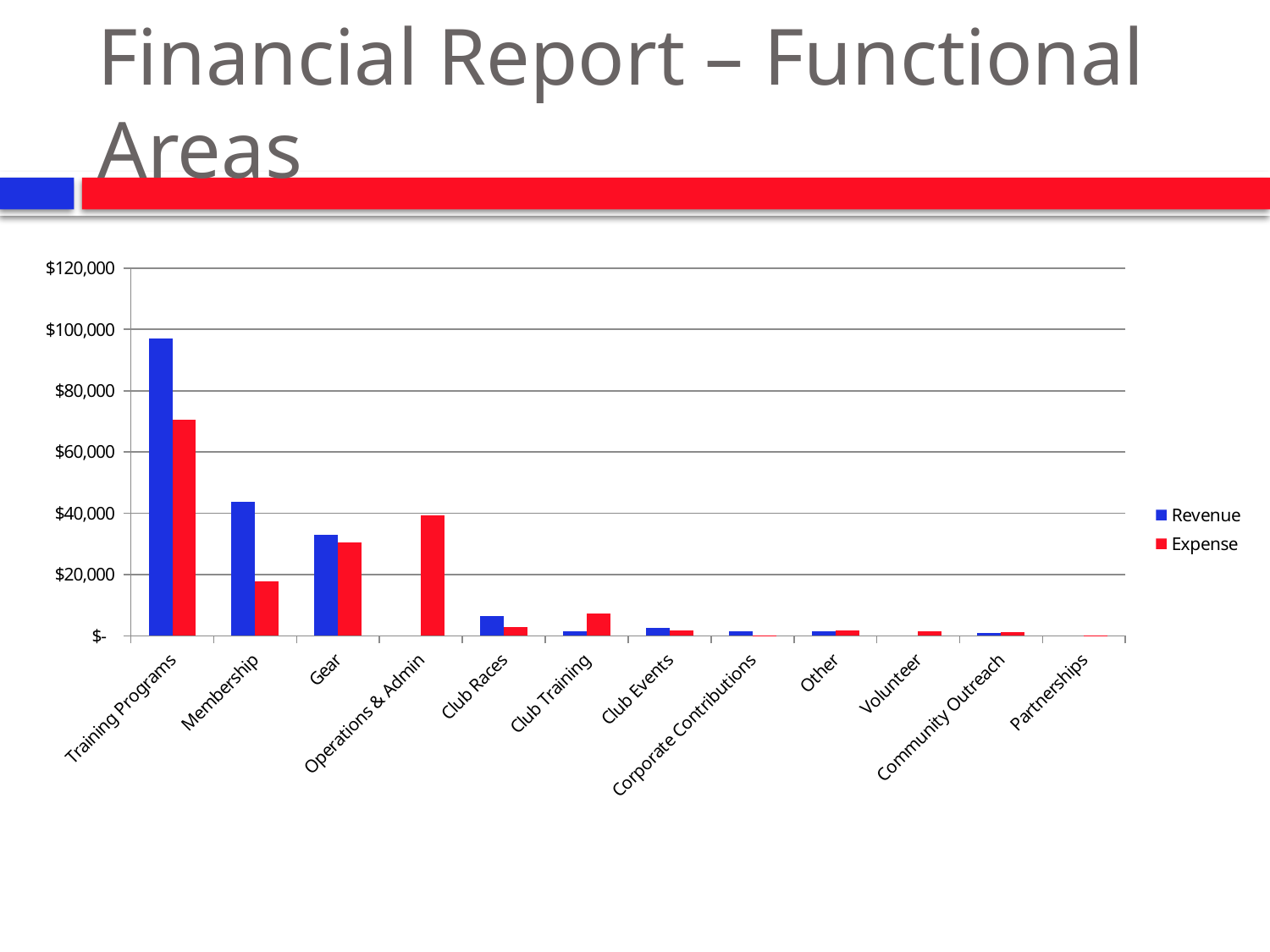
What kind of chart is shown on the slide? bar chart Is the Expense value for Operations & Admin greater or less than $20,000? greater For Club Training, which is larger, Revenue or Expense? Expense How many series does the legend list? 2 Which category has the highest Expense bar? Training Programs Is the Revenue value for Gear greater or less than $20,000? greater Which colour represents the Revenue series in the legend? blue Which category has the highest Revenue bar? Training Programs Is the Expense value for Training Programs greater or less than $60,000? greater How many functional area categories are shown on the x axis? 12 For Membership, which is larger, Revenue or Expense? Revenue